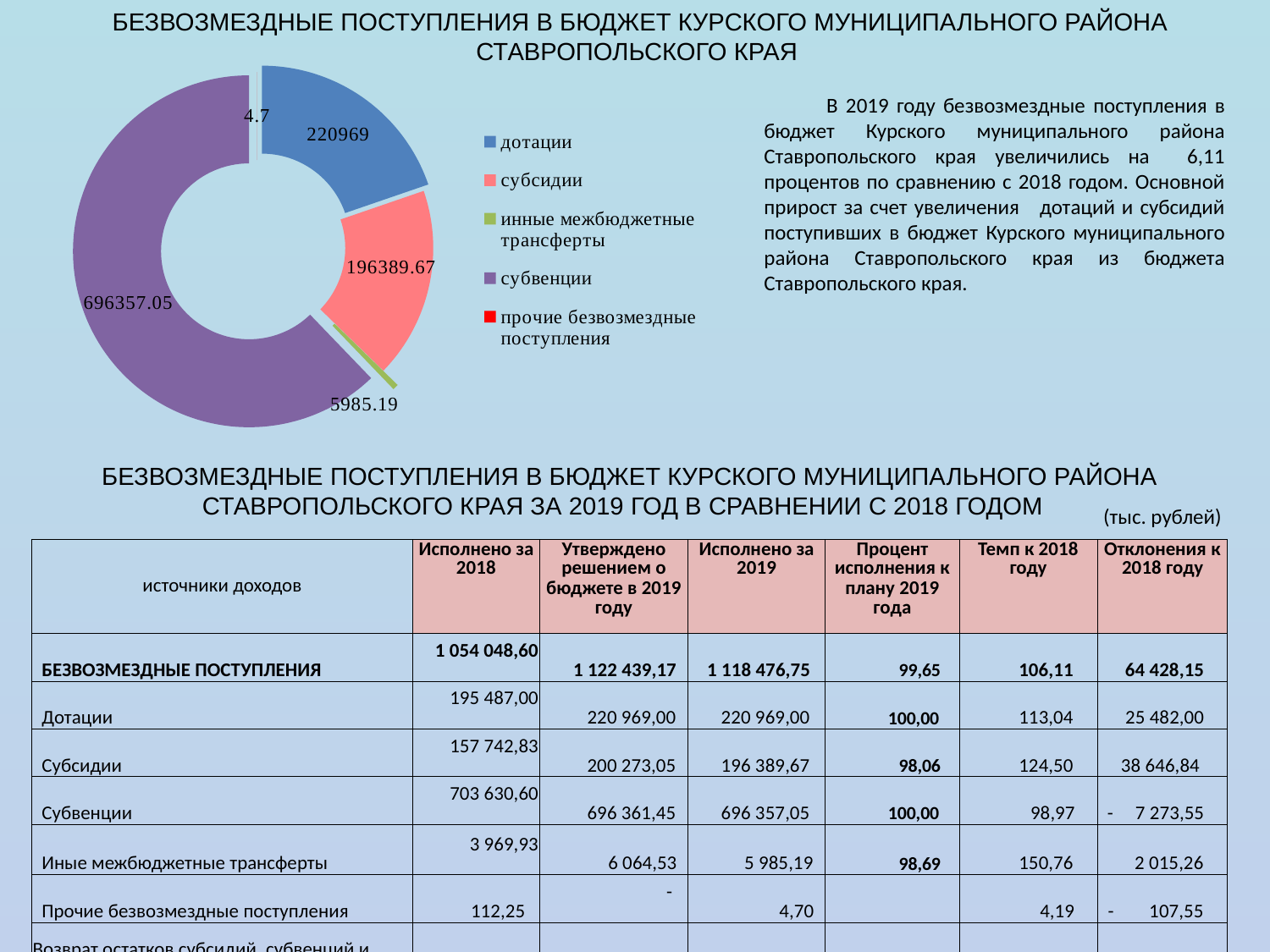
Which is larger in the doughnut chart, дотации or субсидии? дотации Which category has the largest slice in the doughnut chart? субвенции What is the value shown for субвенции on the doughnut chart? 696357.05 What is the value shown for субсидии on the doughnut chart? 196389.67 What is the value shown for дотации on the doughnut chart? 220969 How many categories are plotted in the doughnut chart? 5 What type of chart is shown at the top of the slide? Doughnut (pie) chart Which category has the smallest slice in the doughnut chart? прочие безвозмездные поступления What is the value shown for прочие безвозмездные поступления on the doughnut chart? 4.7 What colour represents субвенции in the doughnut chart legend? Purple What is the value shown for инные межбюджетные трансферты on the doughnut chart? 5985.19 What is the difference between the values for дотации and субсидии in the doughnut chart? 24579.33